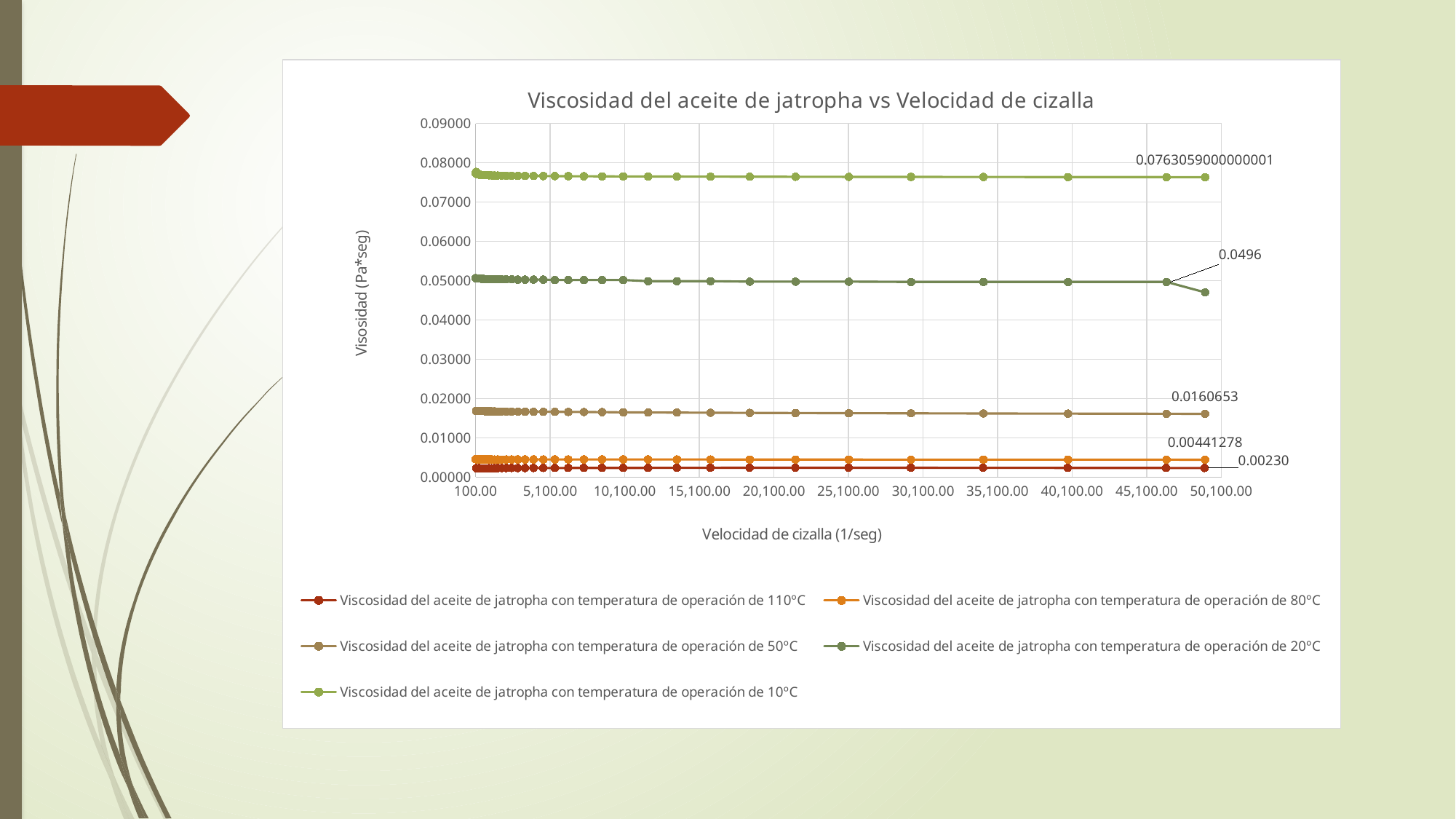
What is the difference between the labelled final values of the 80°C series and the 110°C series? 0.00211278 How many series does the legend list? 5 Which operating temperature series has the highest viscosity values? 10°C What kind of chart is shown on the slide? line chart What is the labelled final value of the series for an operating temperature of 50°C? 0.0160653 What is the labelled final value of the series for an operating temperature of 80°C? 0.00441278 What is the labelled final value of the series for an operating temperature of 20°C? 0.0496 What is the labelled final value of the series for an operating temperature of 10°C? 0.0763059000000001 Is the viscosity for the 20°C series greater or less than 0.04000? greater Which operating temperature series has the lowest viscosity values? 110°C What is the labelled final value of the series for an operating temperature of 110°C? 0.00230 What is the title of the chart? Viscosidad del aceite de jatropha vs Velocidad de cizalla